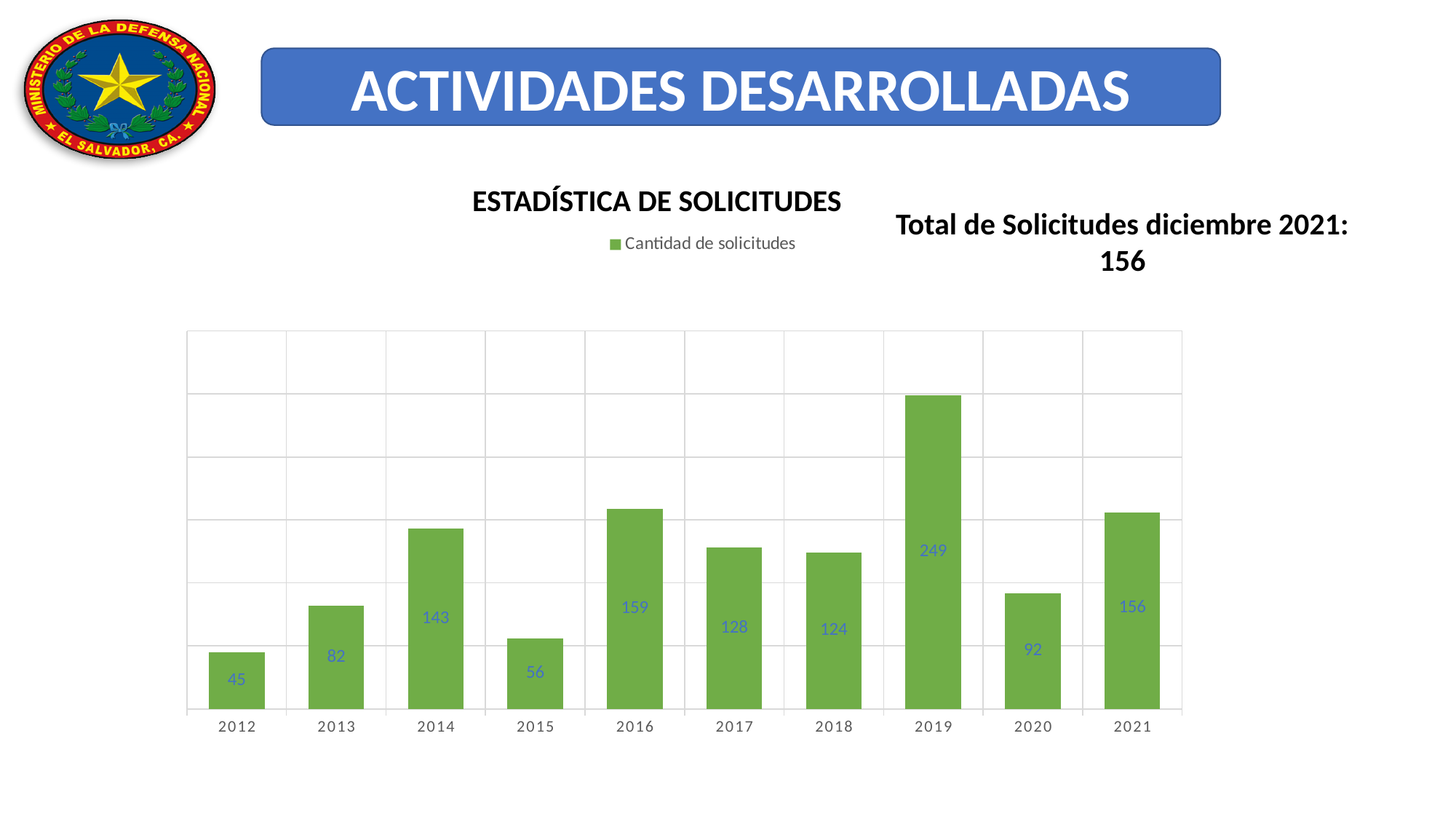
How many series does the legend of the ESTADÍSTICA DE SOLICITUDES chart list? 1 What is the value for 2014 in the ESTADÍSTICA DE SOLICITUDES chart? 143 What kind of chart is the ESTADÍSTICA DE SOLICITUDES chart? Bar chart Which year has the highest value in the ESTADÍSTICA DE SOLICITUDES chart? 2019 What is the difference between the values for 2016 and 2015 in the ESTADÍSTICA DE SOLICITUDES chart? 103 How many years are shown on the x axis of the ESTADÍSTICA DE SOLICITUDES chart? 10 What is the value for 2017 in the ESTADÍSTICA DE SOLICITUDES chart? 128 What is the difference between the values for 2019 and 2021 in the ESTADÍSTICA DE SOLICITUDES chart? 93 What is the value for 2020 in the ESTADÍSTICA DE SOLICITUDES chart? 92 What is the legend entry of the ESTADÍSTICA DE SOLICITUDES chart? Cantidad de solicitudes Which is larger in the ESTADÍSTICA DE SOLICITUDES chart, the value for 2013 or the value for 2020? 2020 Which year has the lowest value in the ESTADÍSTICA DE SOLICITUDES chart? 2012